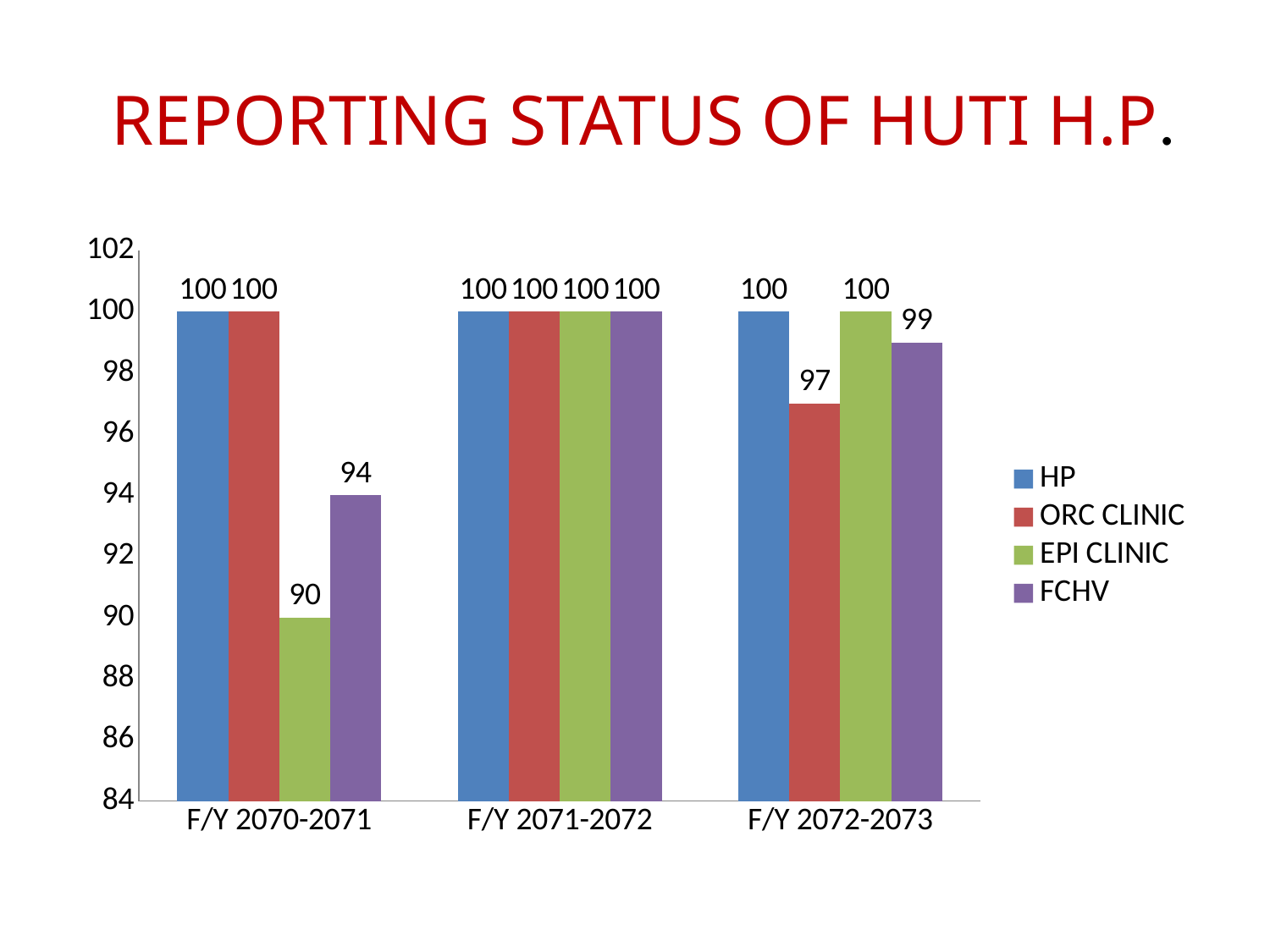
What kind of chart is shown on the slide? Bar chart Which is larger in F/Y 2072-2073, ORC CLINIC or FCHV? FCHV What is the difference between the FCHV and EPI CLINIC values in F/Y 2070-2071? 4 How many fiscal year categories are shown on the x axis? 3 Which series has the lowest value in F/Y 2072-2073? ORC CLINIC What is the value for ORC CLINIC in F/Y 2072-2073? 97 How many series does the legend list? 4 Which series has the lowest value in F/Y 2070-2071? EPI CLINIC What is the value for FCHV in F/Y 2072-2073? 99 What is the value for FCHV in F/Y 2070-2071? 94 Does the EPI CLINIC value rise or fall from F/Y 2070-2071 to F/Y 2071-2072? Rise What is the value for EPI CLINIC in F/Y 2070-2071? 90